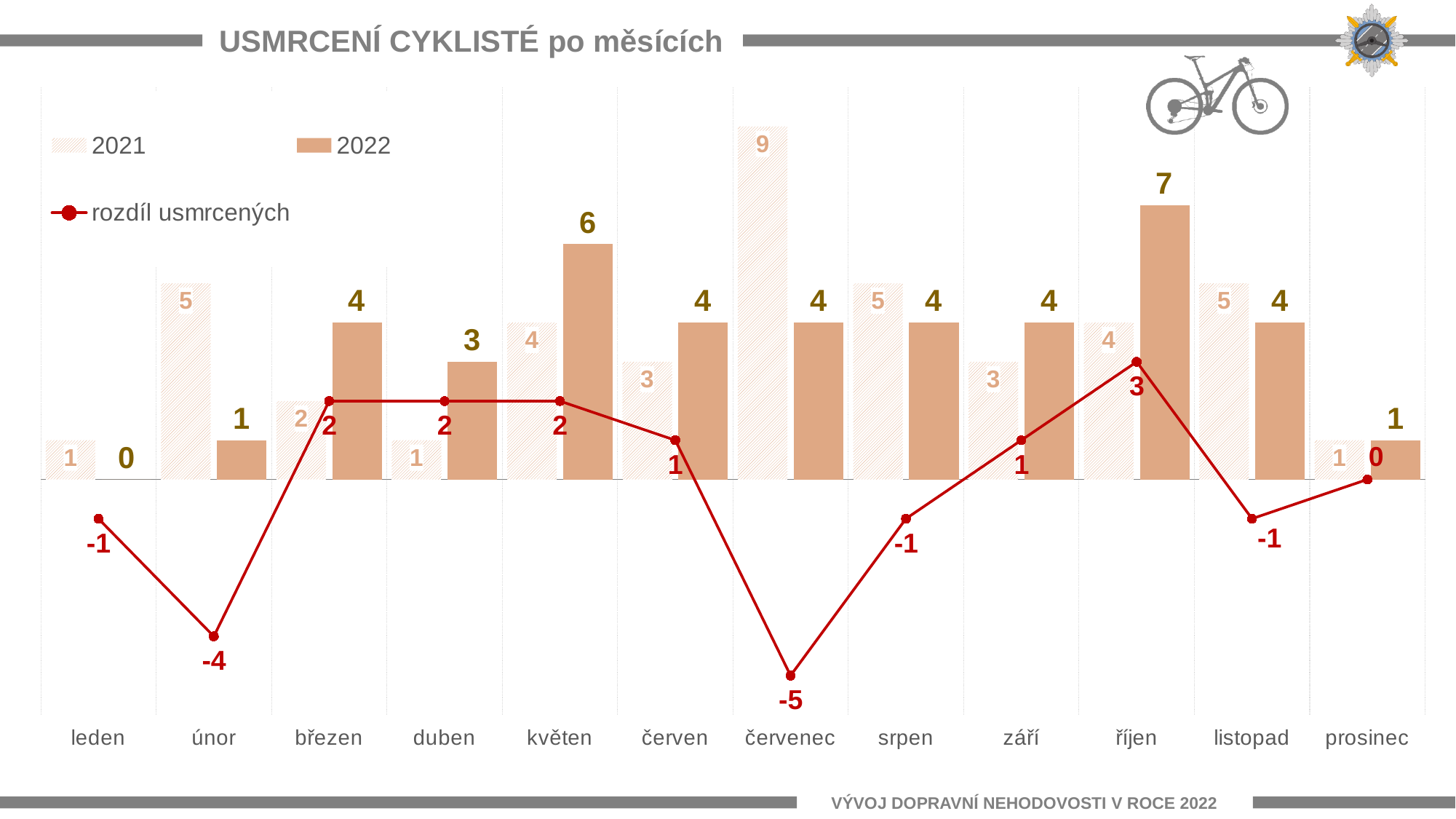
What is the 2021 value for červenec? 9 What is the difference between the 2022 and 2021 values for květen? 2 Which is larger for srpen, the 2021 value or the 2022 value? 2021 What kind of chart is this? Combined bar and line chart What is the value of 'rozdíl usmrcených' for únor? -4 How many series does the legend list? 3 Which month has the highest 2021 value? červenec How many months are shown on the x axis? 12 What is the title of the chart? USMRCENÍ CYKLISTÉ po měsících Which month has the lowest value of 'rozdíl usmrcených'? červenec Which month has the highest 2022 value? říjen What is the 2022 value for říjen? 7